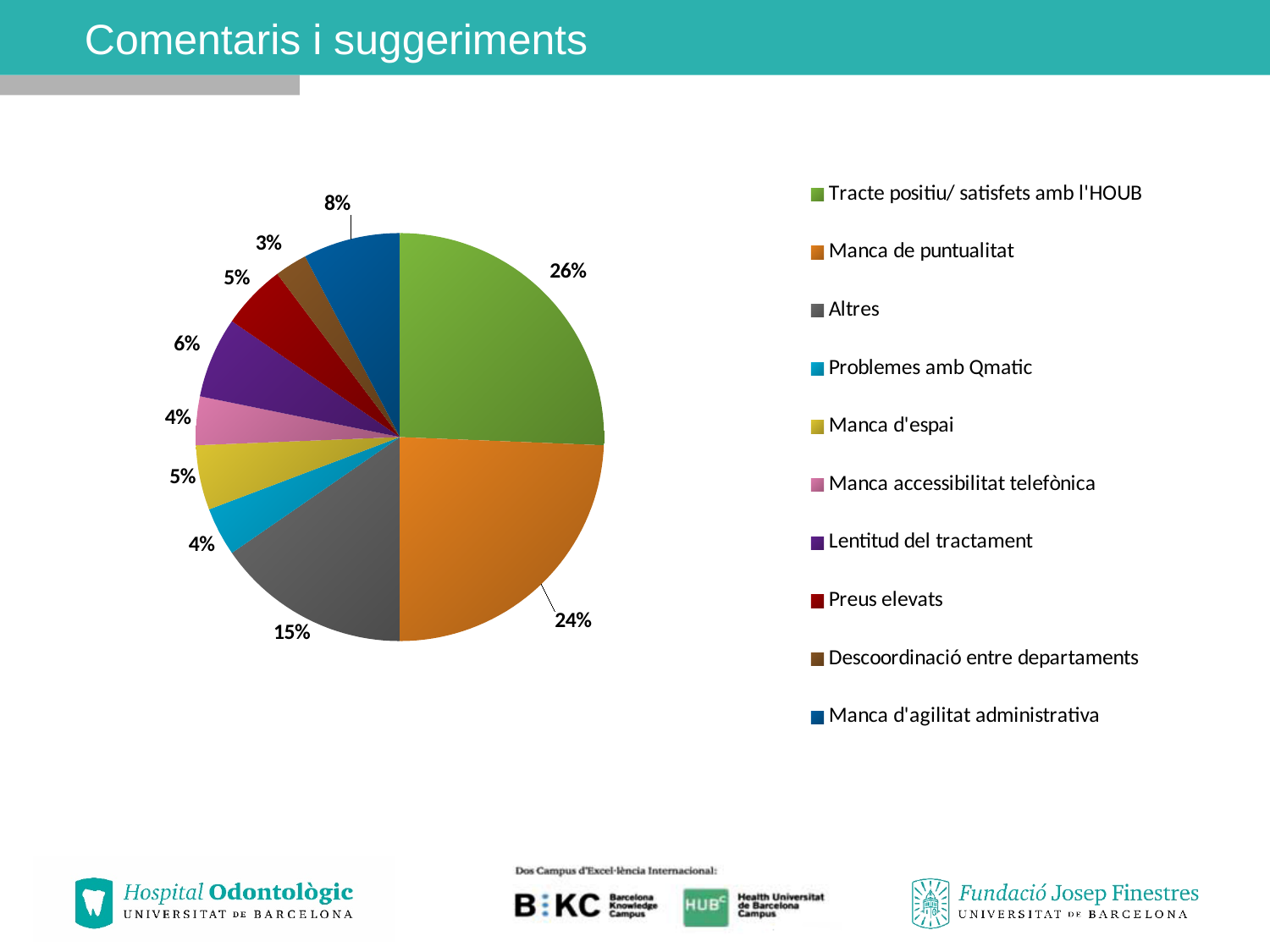
Which category has the smallest slice of the pie? Descoordinació entre departaments What percentage is shown for 'Manca de puntualitat'? 24% What kind of chart is shown on the slide? pie chart What is the difference in percentage points between 'Tracte positiu/ satisfets amb l'HOUB' and 'Manca de puntualitat'? 2 percentage points What percentage is shown for 'Lentitud del tractament'? 6% What percentage is shown for 'Manca d'agilitat administrativa'? 8% Which category has the largest slice of the pie? Tracte positiu/ satisfets amb l'HOUB Which is larger, the slice for 'Altres' or the slice for 'Manca d'agilitat administrativa'? Altres What is the title of the slide containing the pie chart? Comentaris i suggeriments What percentage is shown for 'Altres'? 15% How many categories does the legend list? 10 What share of the pie does 'Tracte positiu/ satisfets amb l'HOUB' represent? 26%